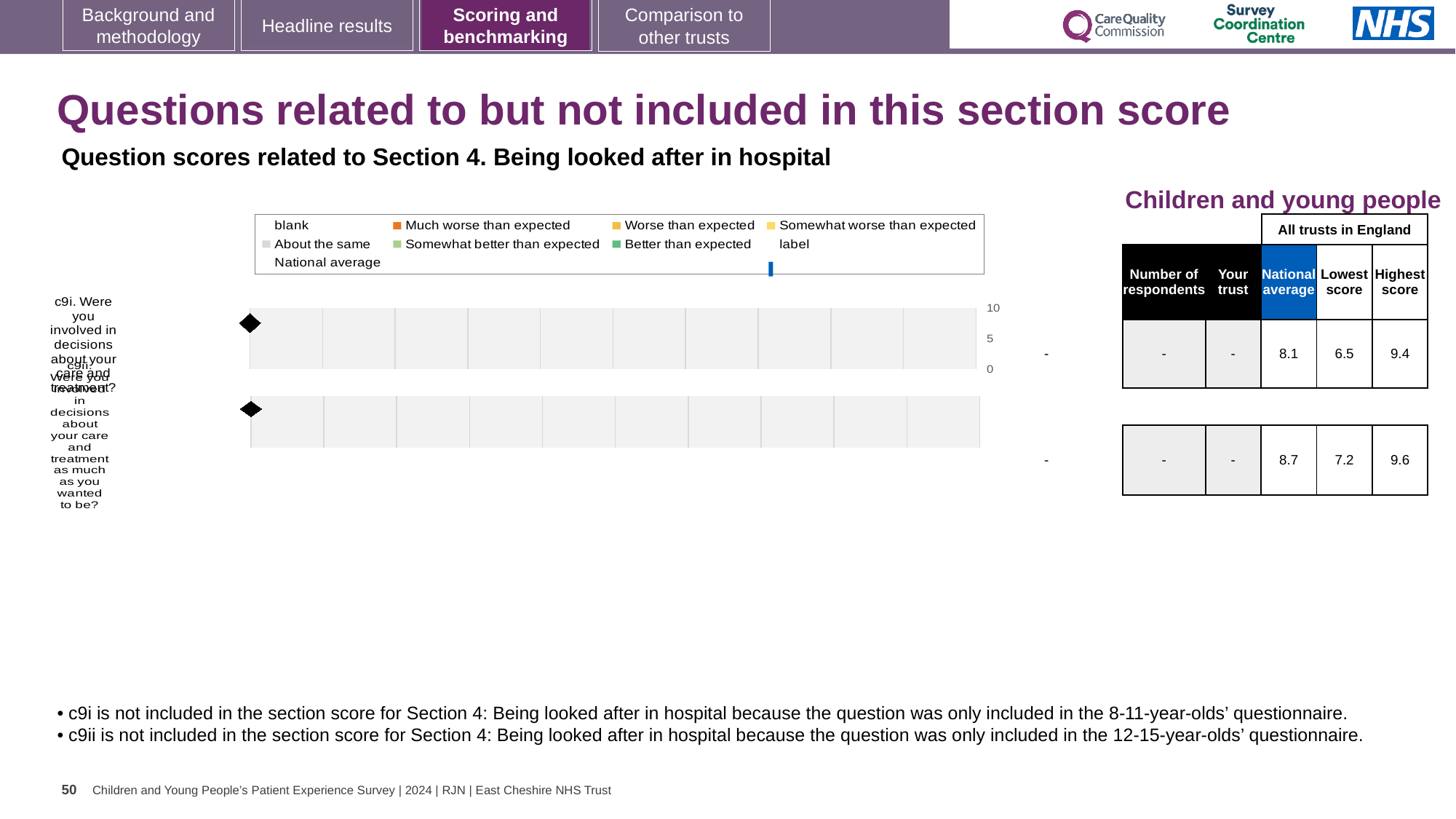
What kind of chart is shown on the slide? bar chart In the table beside the chart, what is the difference between the national averages of c9ii and c9i? 0.6 In the table beside the chart, what is the highest score across all trusts in England for c9ii? 9.6 How many question categories are listed on the chart's vertical axis? 2 In the table beside the chart, what is the national average score for c9ii? 8.7 In the table beside the chart, what is the difference between the highest and lowest scores for c9i? 2.9 In the table beside the chart, what is the national average score for c9i? 8.1 What is the highest value shown on the chart's numeric axis? 10 In the table beside the chart, which question has the higher national average, c9i or c9ii? c9ii In the table beside the chart, what is the lowest score across all trusts in England for c9i? 6.5 What colour is the legend marker for 'Much worse than expected'? orange